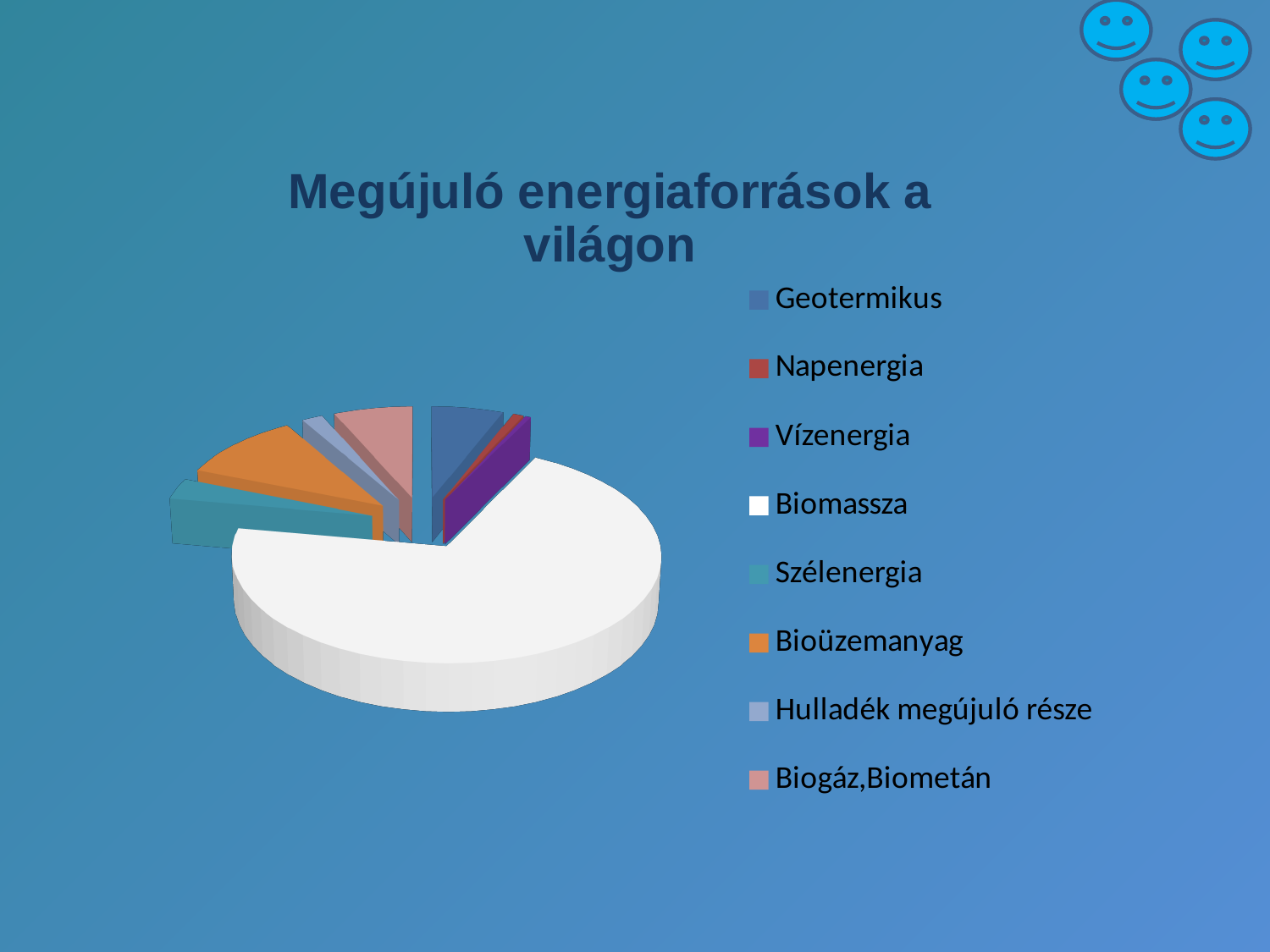
What kind of chart is shown on the slide? pie chart What colour is the Biomassza slice in the pie chart? white Which slice is larger, Bioüzemanyag or Geotermikus? Bioüzemanyag Which slice is larger, Biomassza or Vízenergia? Biomassza Which category has the largest slice of the pie? Biomassza Which slice is larger, Szélenergia or Napenergia? Szélenergia What is the title of the chart? Megújuló energiaforrások a világon How many categories does the pie chart's legend list? 8 Does the Biomassza slice take up more or less than half of the pie? more